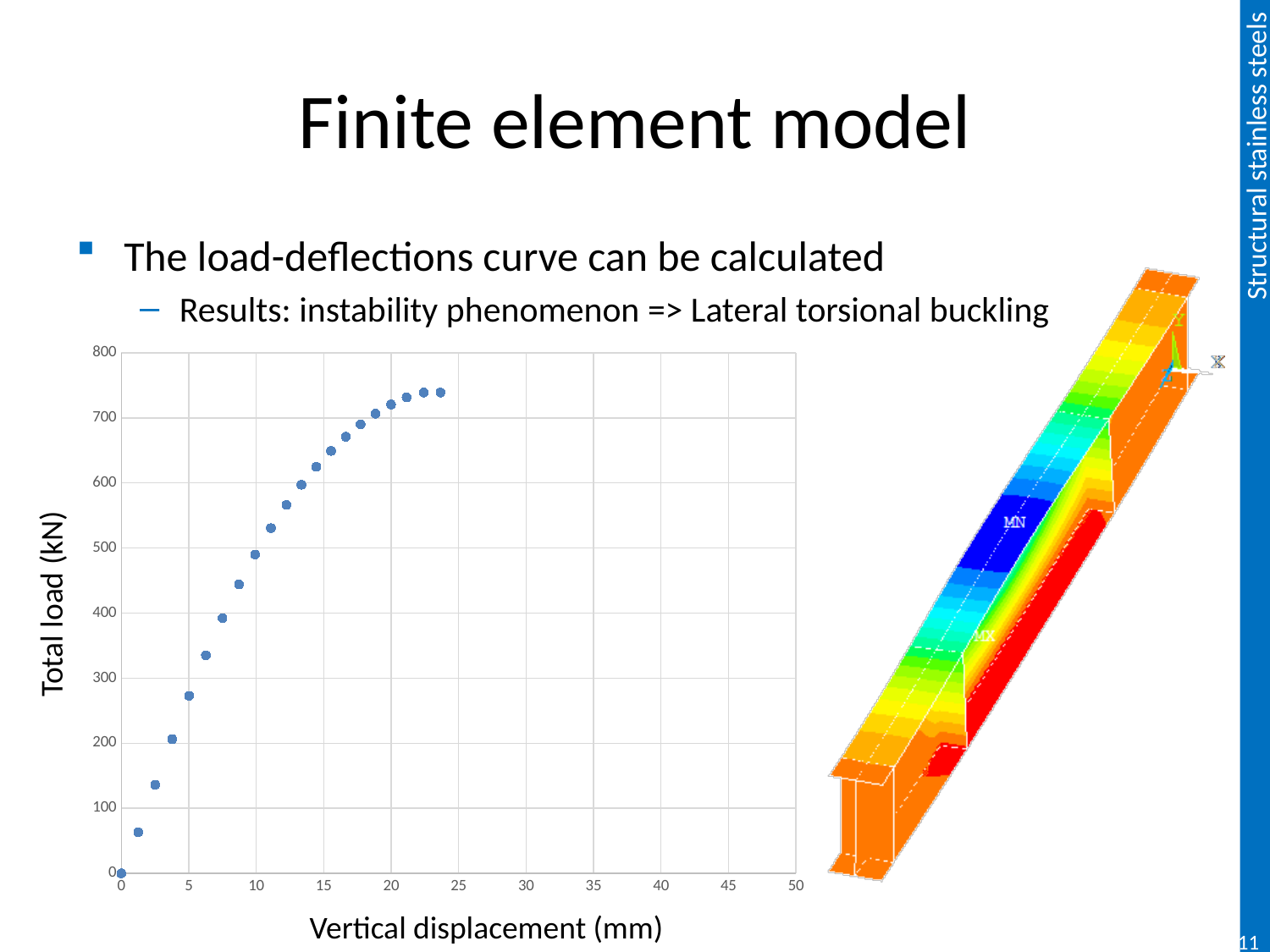
Is the total load at a vertical displacement of 5 mm greater or less than 200 kN? greater What is the label of the vertical axis of the chart? Total load (kN) Is the highest total load reached in the chart greater or less than 700 kN? greater What is the total load at a vertical displacement of 0 mm? 0 Is the total load at a vertical displacement of 20 mm greater or less than 700 kN? greater What is the label of the horizontal axis of the chart? Vertical displacement (mm) What kind of chart is shown on the slide? scatter chart Does the total load rise or fall as vertical displacement increases along the x axis? rises